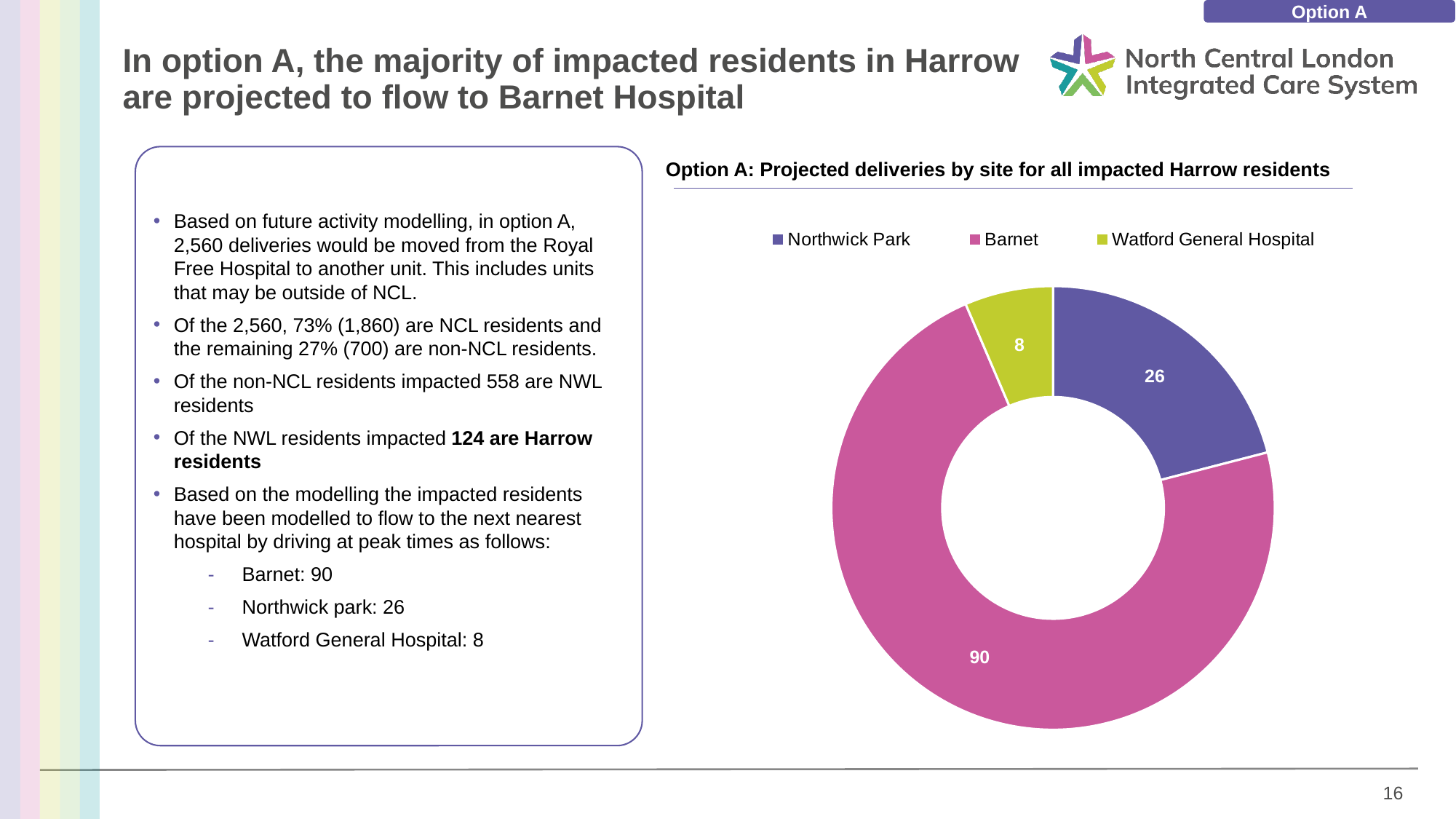
Which is larger, the value for Northwick Park or the value for Watford General Hospital? Northwick Park What is the value for Barnet in the chart? 90 What is the total of all values shown in the chart? 124 Which site has the highest projected deliveries in the chart? Barnet What kind of chart is shown on the slide? Doughnut (pie) chart What is the title of the chart? Option A: Projected deliveries by site for all impacted Harrow residents What is the difference between the values for Northwick Park and Watford General Hospital? 18 How many sites are shown in the chart? 3 What is the value for Northwick Park in the chart? 26 What is the difference between the values for Barnet and Northwick Park? 64 Which site has the lowest projected deliveries in the chart? Watford General Hospital What is the value for Watford General Hospital in the chart? 8